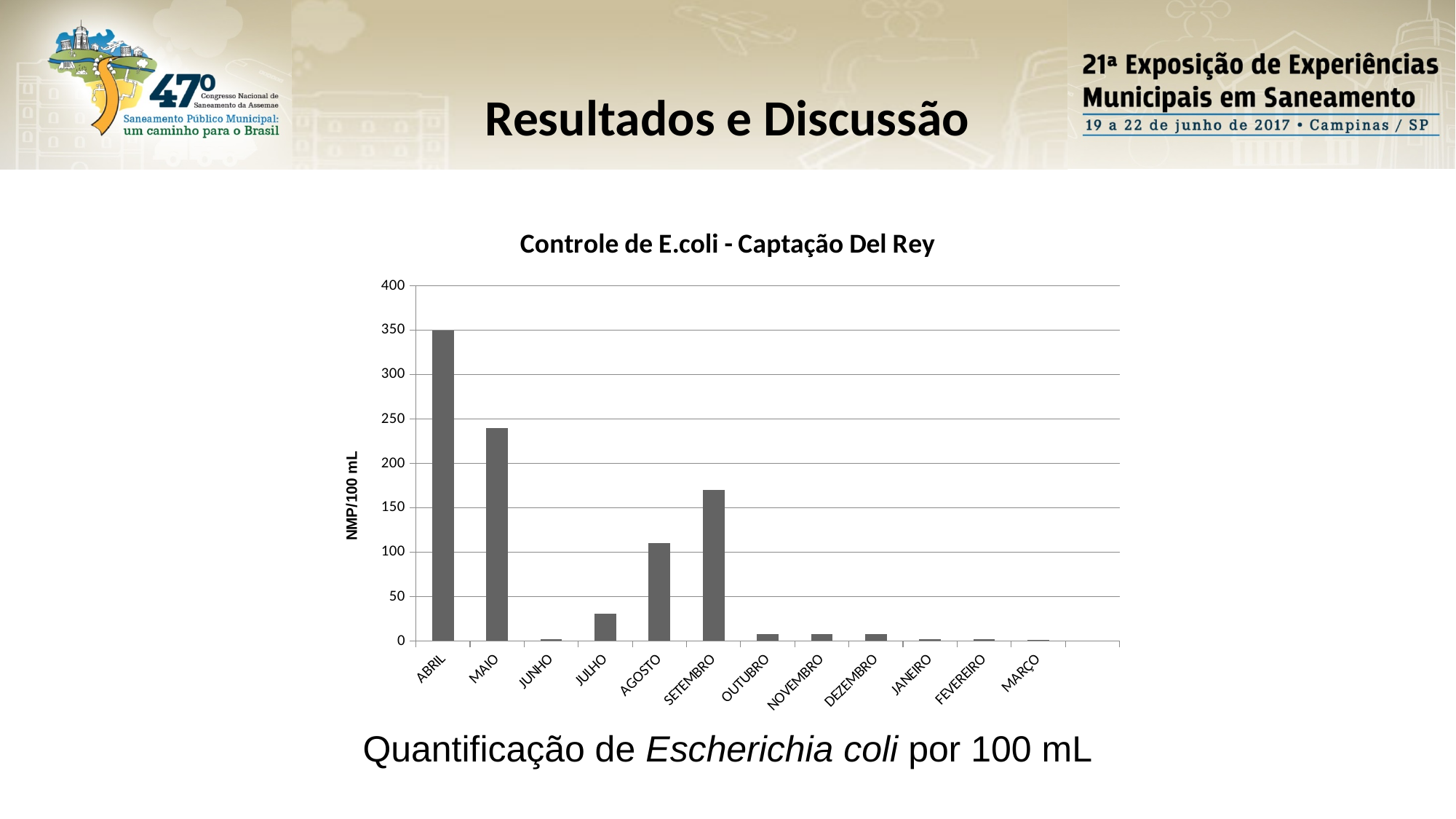
Which month has the highest E. coli value? ABRIL Which is larger, the value for MAIO or the value for SETEMBRO? MAIO Is the value for JULHO greater or less than 50? less Is the value for MAIO greater or less than 200? greater What is the title of the chart? Controle de E.coli - Captação Del Rey How many months are shown on the x axis of the chart? 12 What type of chart is shown on the slide? bar chart Is the value for SETEMBRO greater or less than 150? greater What is the value for ABRIL? 350 Do the values generally rise or fall from ABRIL to MARÇO? fall What is the label of the vertical axis? NMP/100 mL